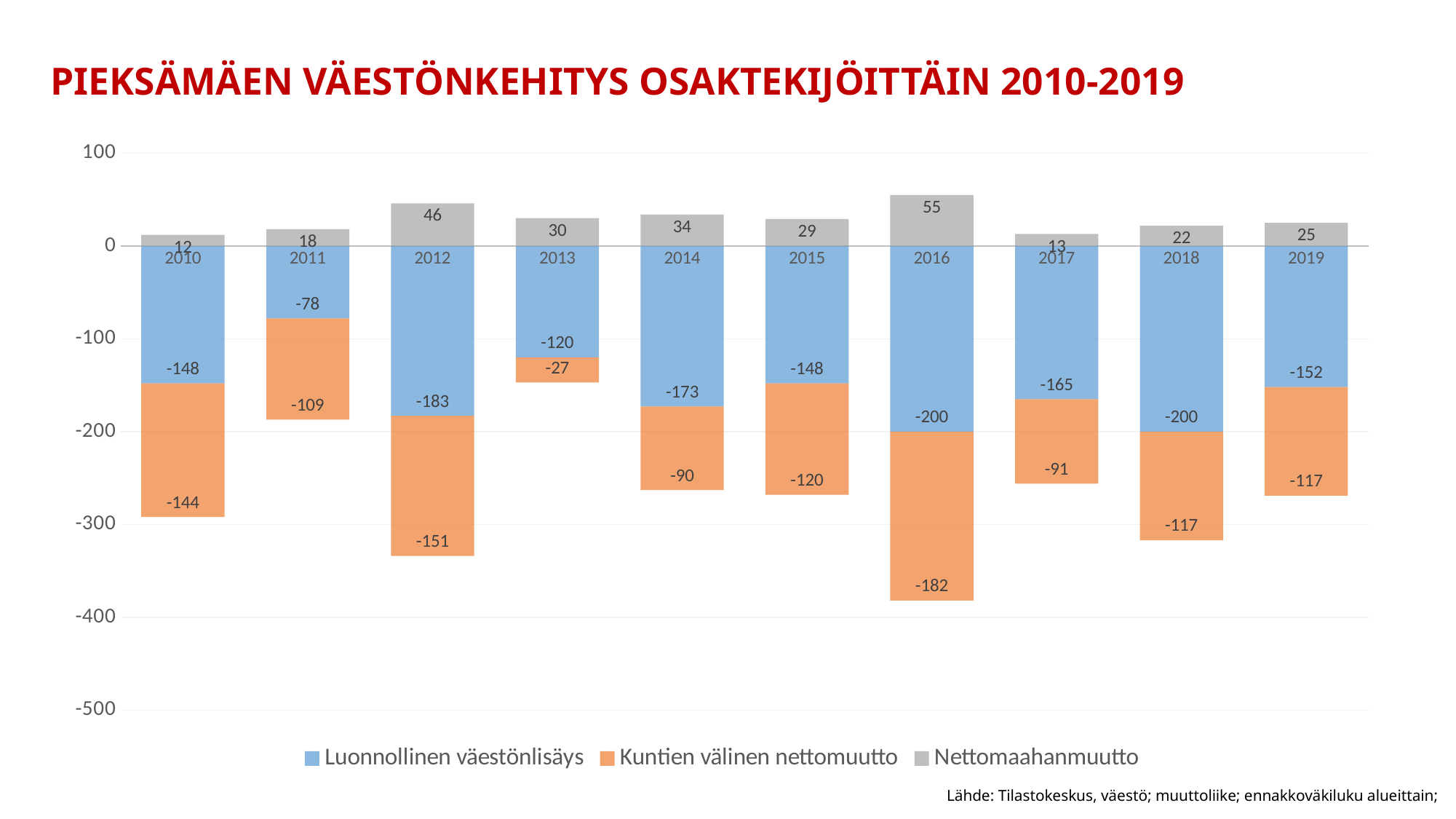
How many years are shown on the x axis? 10 Which year has the larger Nettomaahanmuutto value, 2014 or 2015? 2014 What is the value of Kuntien välinen nettomuutto for 2013? -27 What is the total of the three components for 2010? -280 What is the value of Luonnollinen väestönlisäys for 2011? -78 In which year is Kuntien välinen nettomuutto most negative? 2016 Which colour represents Kuntien välinen nettomuutto in the legend? Orange In which year is Nettomaahanmuutto highest? 2016 What is the difference between Nettomaahanmuutto in 2012 and in 2013? 16 What is the value of Nettomaahanmuutto for 2016? 55 What kind of chart is shown on the slide? Stacked bar chart How many series does the legend list? 3